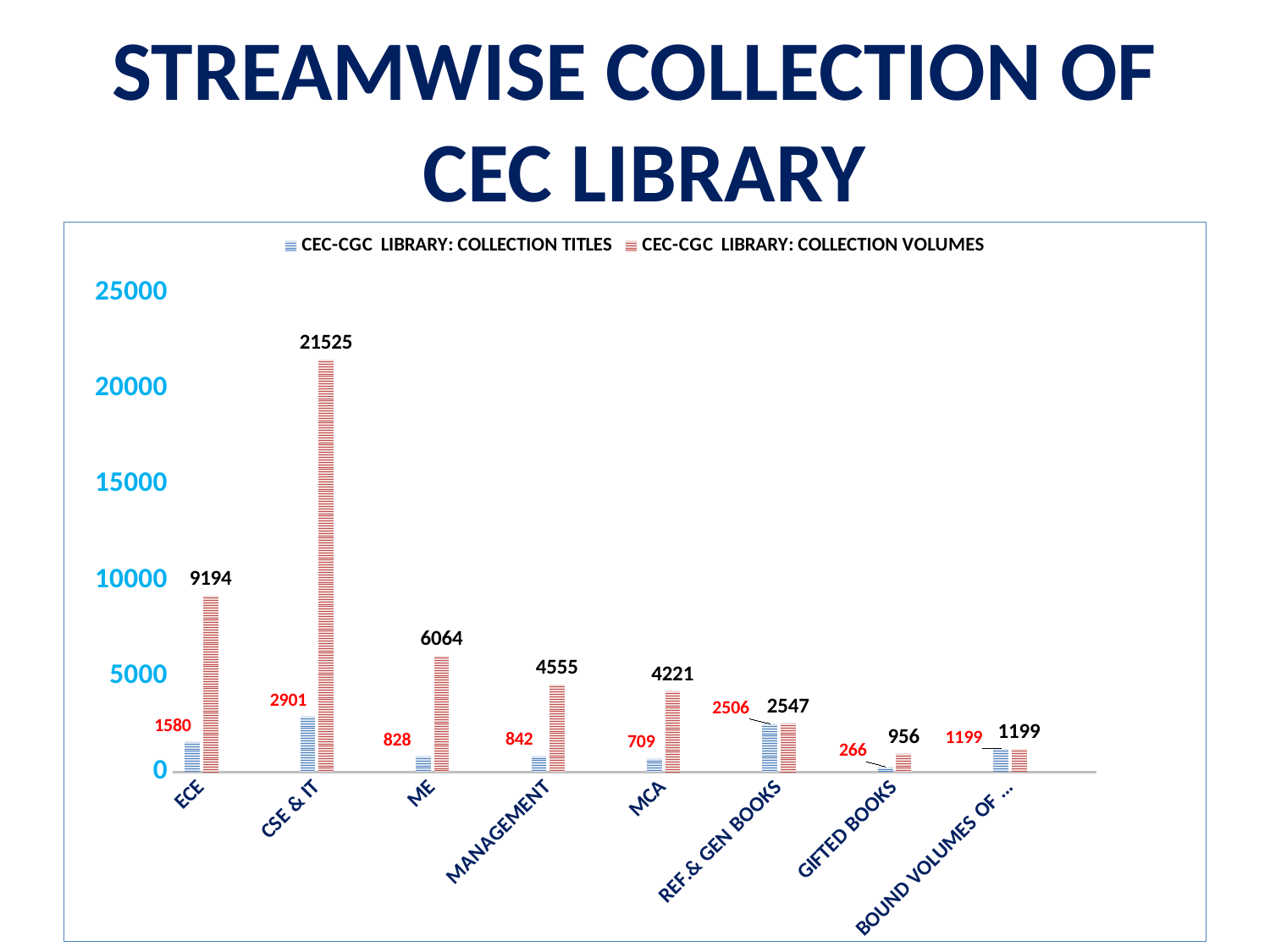
What is the value of CEC-CGC LIBRARY: COLLECTION VOLUMES for CSE & IT? 21525 What is the value of CEC-CGC LIBRARY: COLLECTION TITLES for MCA? 709 What is the difference between COLLECTION VOLUMES and COLLECTION TITLES for REF.& GEN BOOKS? 41 How many categories are shown on the x axis of the chart? 8 What is the difference between COLLECTION VOLUMES and COLLECTION TITLES for ECE? 7614 How many series does the chart legend list? 2 What kind of chart is shown on the slide? bar chart Which category has the lowest CEC-CGC LIBRARY: COLLECTION TITLES? GIFTED BOOKS Is the value of COLLECTION VOLUMES for ECE greater or less than 10000? less Which category has the highest CEC-CGC LIBRARY: COLLECTION VOLUMES? CSE & IT What is the value of CEC-CGC LIBRARY: COLLECTION TITLES for ECE? 1580 Which has the larger CEC-CGC LIBRARY: COLLECTION VOLUMES, ME or MANAGEMENT? ME